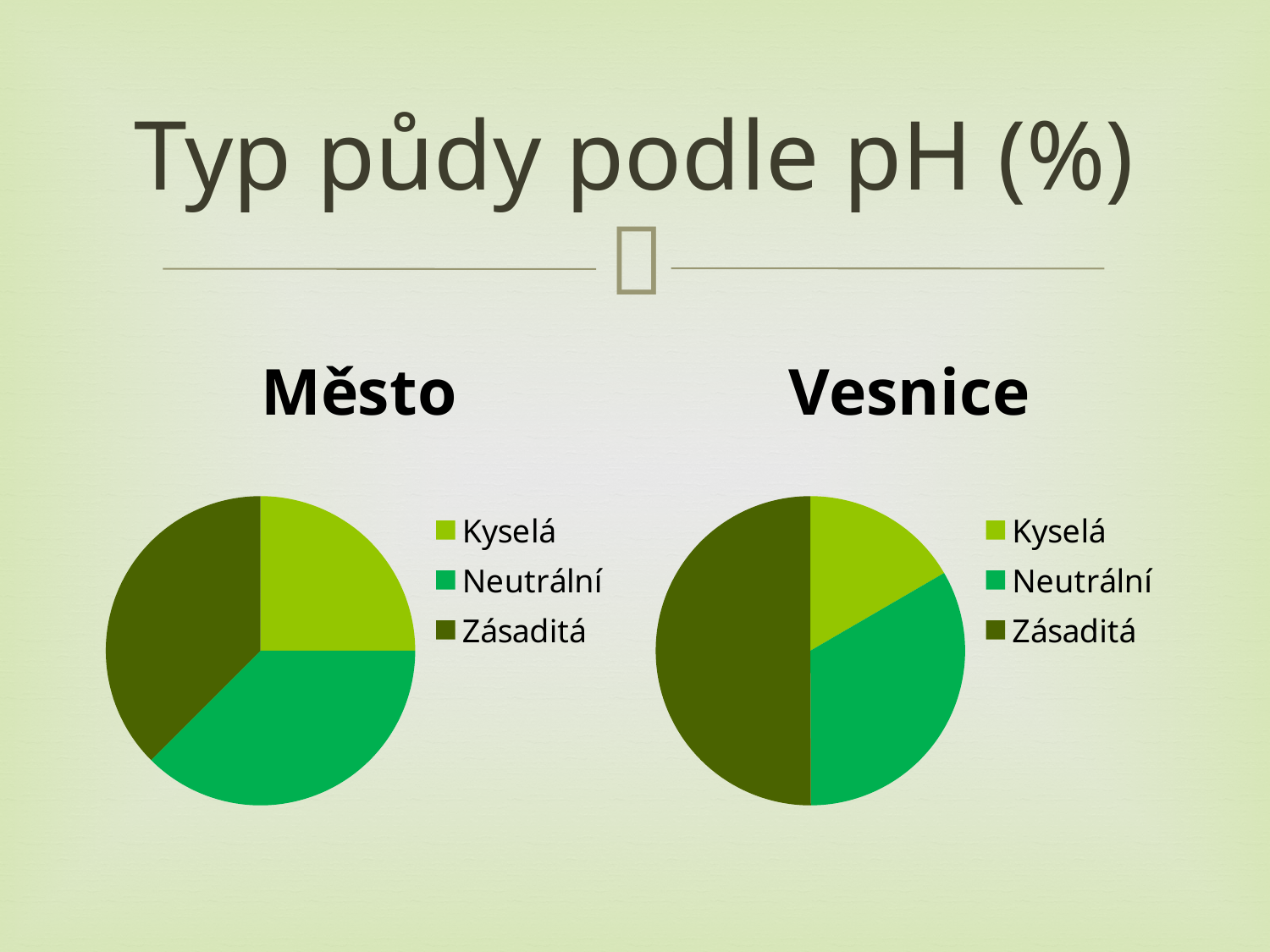
What kind of chart is the Vesnice chart? pie chart In the Město pie chart, which legend entry is shown in the darkest green? Zásaditá In the Město pie chart, which category has the smallest slice? Kyselá How many slices does the Vesnice pie chart have? 3 In the Vesnice pie chart, which category has the largest slice? Zásaditá In the Vesnice pie chart, which category has the smallest slice? Kyselá What is the title of the slide containing the two pie charts? Typ půdy podle pH (%) What kind of chart is the Město chart? pie chart In the Vesnice pie chart, which slice is larger, Kyselá or Neutrální? Neutrální How many entries does the legend of the Vesnice chart list? 3 How many slices does the Město pie chart have? 3